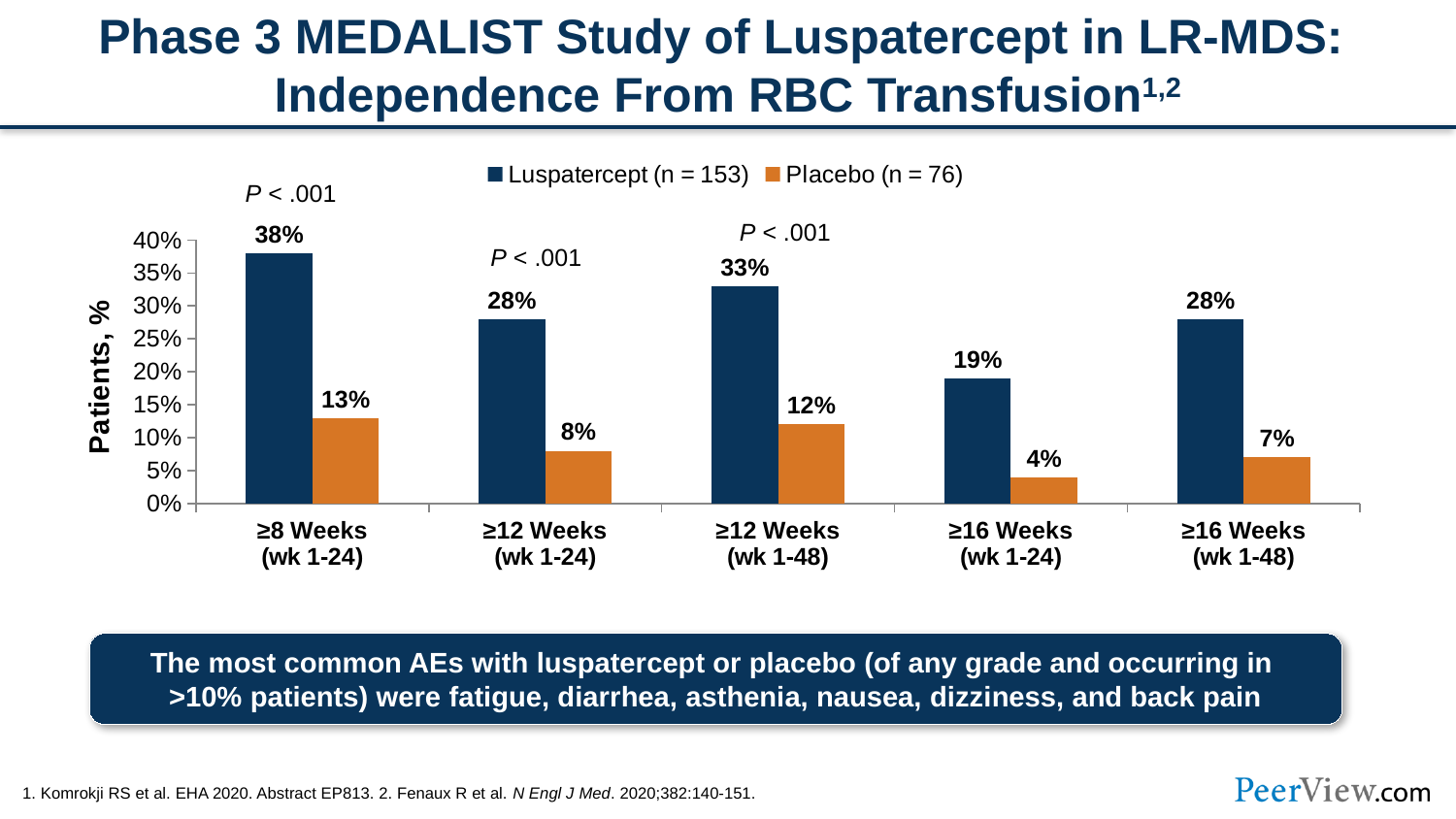
What is the value for Luspatercept at ≥8 Weeks (wk 1-24)? 38% What is the label of the y axis? Patients, % How many series does the legend list? 2 Which is larger: the Placebo value at ≥8 Weeks (wk 1-24) or the Placebo value at ≥16 Weeks (wk 1-48)? ≥8 Weeks (wk 1-24) Which category has the lowest Placebo value? ≥16 Weeks (wk 1-24) What sample size is given for the Placebo group in the legend? n = 76 What is the value for Placebo at ≥12 Weeks (wk 1-48)? 12% How many categories are shown on the x axis? 5 What kind of chart is shown on the slide? Bar chart Which category has the highest Luspatercept value? ≥8 Weeks (wk 1-24) What is the difference between the Luspatercept and Placebo values at ≥12 Weeks (wk 1-24)? 20% What is the value for Placebo at ≥16 Weeks (wk 1-24)? 4%